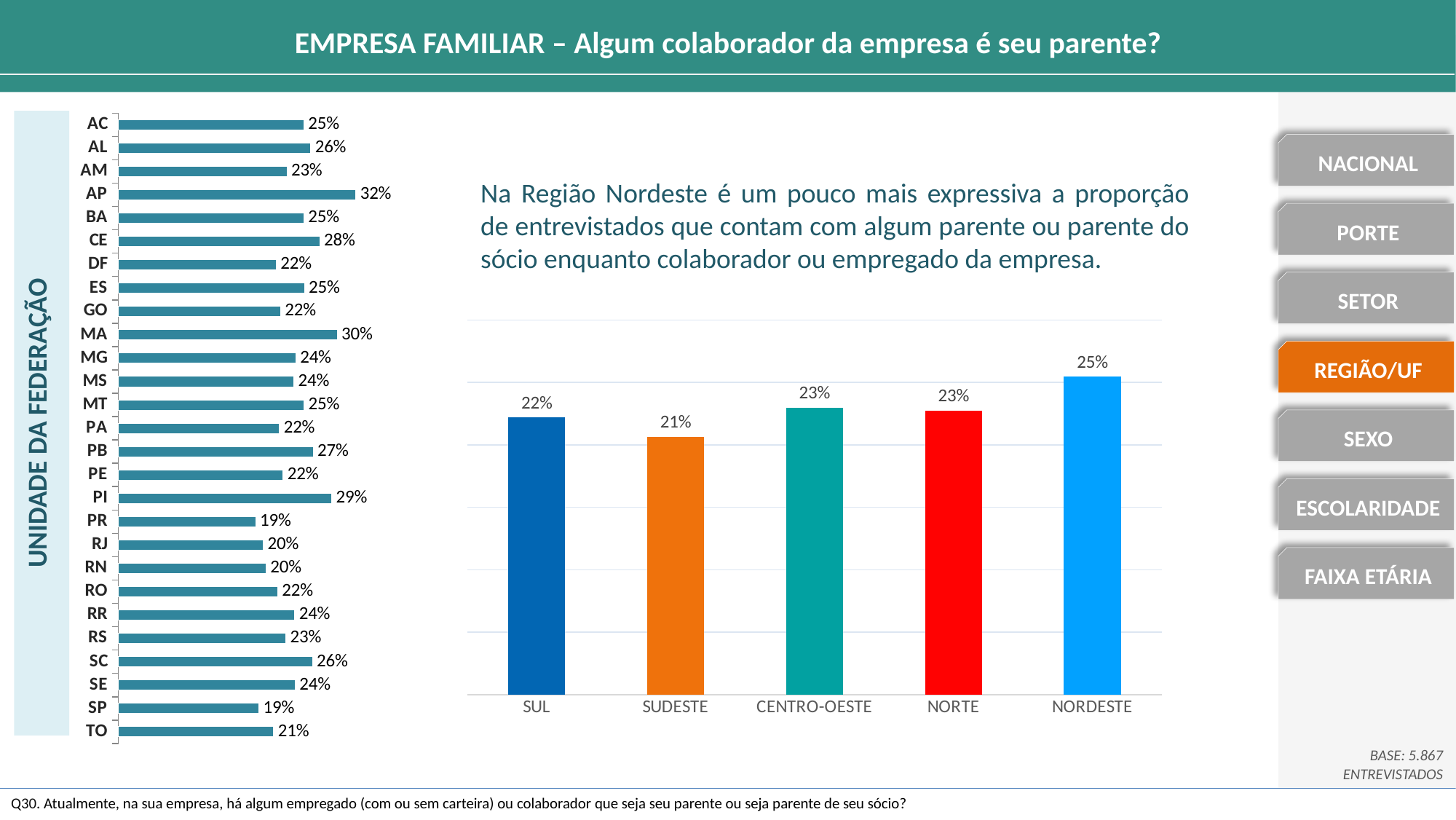
In the left chart (by unidade da federação), how many states are listed? 27 In the right chart (by region), what is the difference between NORDESTE and SUDESTE? 4% In the right chart (by region), how many regions are shown? 5 In the left chart (by unidade da federação), what is the value for AP? 32% In the left chart (by unidade da federação), what is the difference between MA and SP? 11% In the right chart (by region), which region has the highest value? NORDESTE In the left chart (by unidade da federação), which is larger, CE or RJ? CE In the left chart (by unidade da federação), which state has the highest value? AP In the right chart (by region), which region has the lowest value? SUDESTE In the left chart (by unidade da federação), what is the value for PI? 29% What type of chart is the right chart (by region)? Bar chart In the right chart (by region), what is the value for NORDESTE? 25%